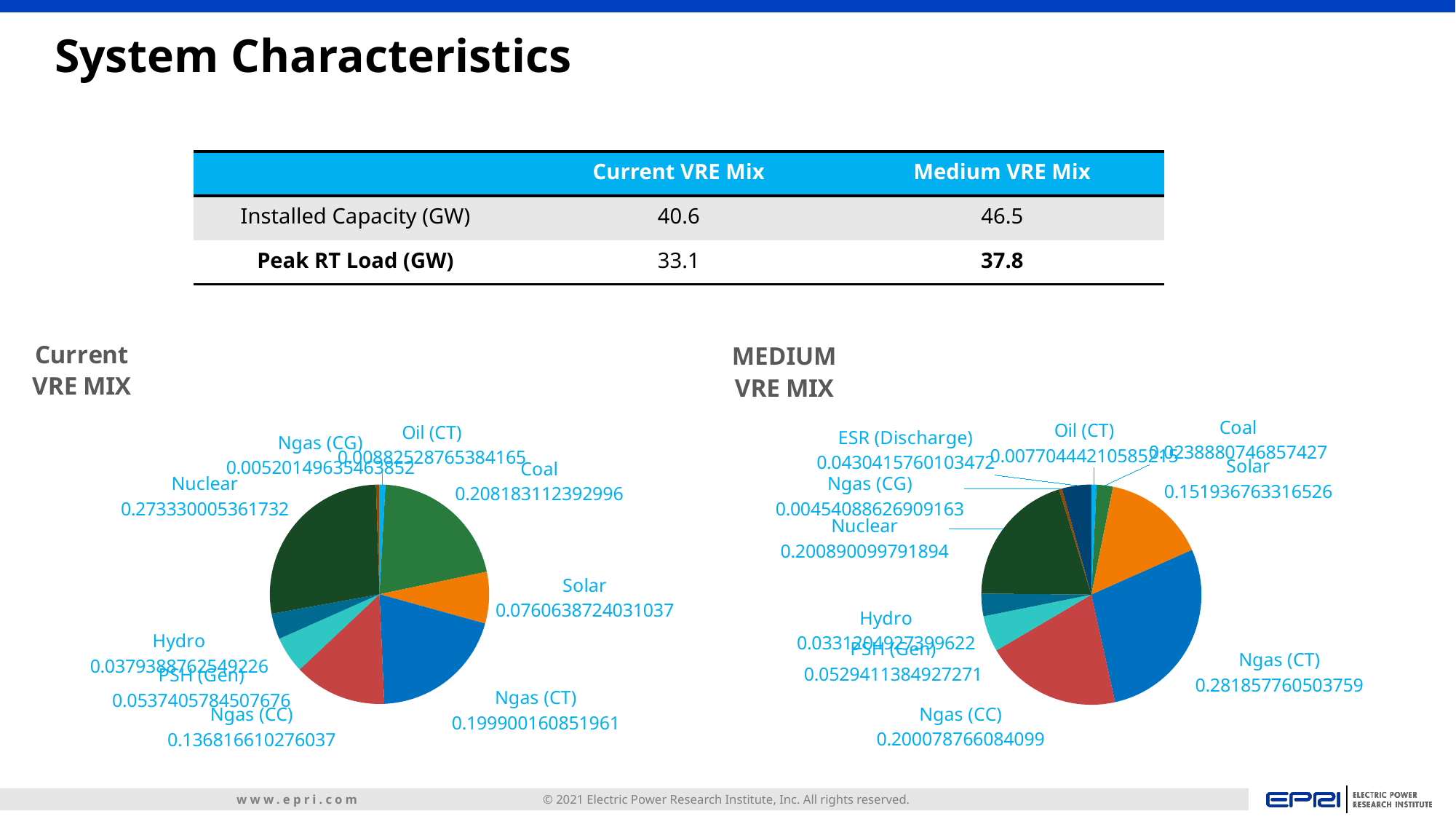
In the MEDIUM VRE MIX pie chart, which category has the largest share? Ngas (CT) In the MEDIUM VRE MIX pie chart, which is larger, Solar or Coal? Solar In the Current VRE MIX pie chart, what is the value for Nuclear? 0.273330005361732 How many categories are shown in the MEDIUM VRE MIX pie chart? 10 In the MEDIUM VRE MIX pie chart, what is the value for Ngas (CT)? 0.281857760503759 In the Current VRE MIX pie chart, which category has the largest share? Nuclear In the Current VRE MIX pie chart, which is larger, Ngas (CT) or Ngas (CC)? Ngas (CT) In the Current VRE MIX pie chart, what is the value for Coal? 0.208183112392996 What kind of chart is the Current VRE MIX chart on the left? pie chart Which category appears in the MEDIUM VRE MIX pie chart but not in the Current VRE MIX pie chart? ESR (Discharge) How many categories are shown in the Current VRE MIX pie chart? 9 In the MEDIUM VRE MIX pie chart, what is the value for Solar? 0.151936763316526